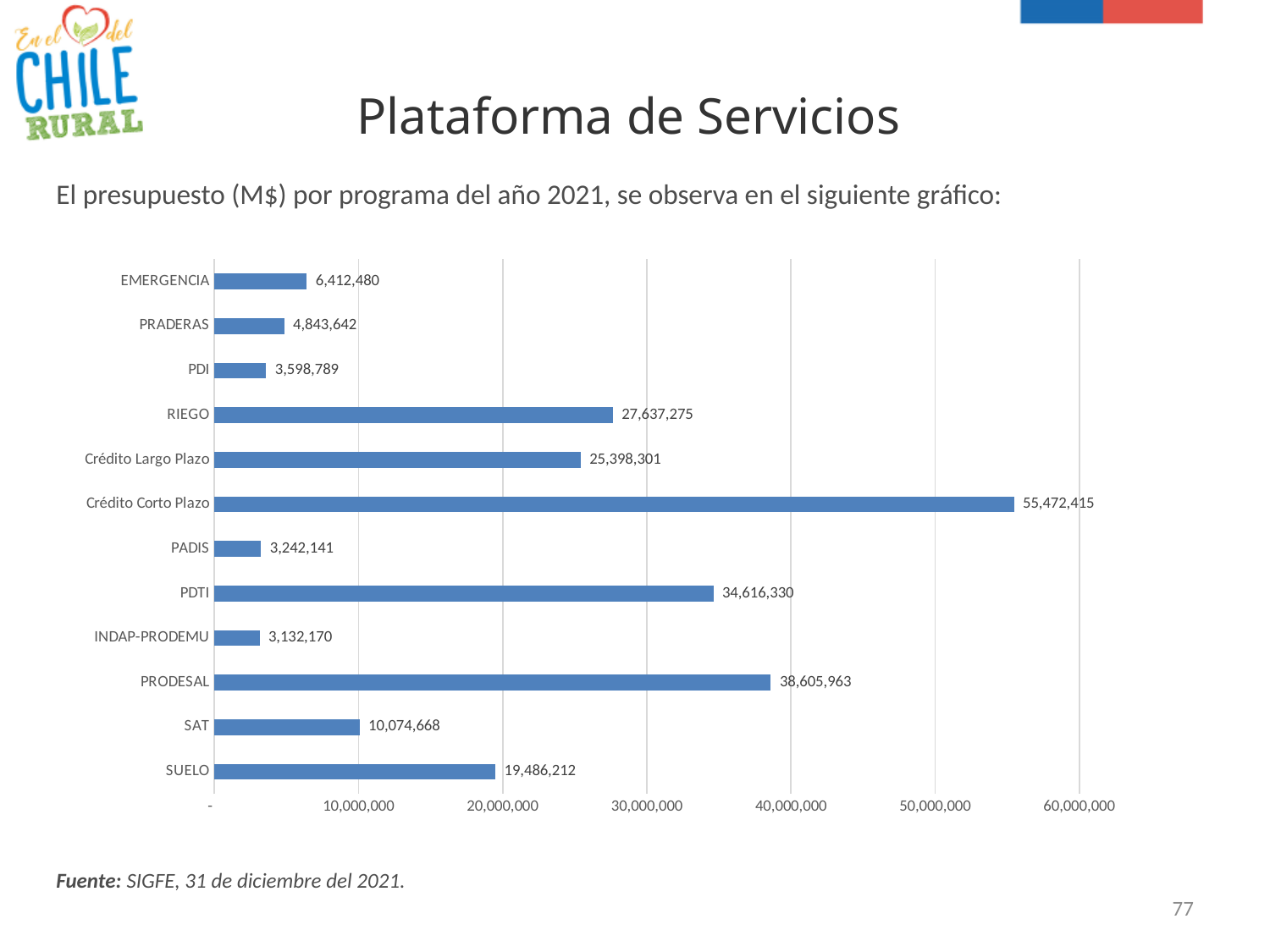
How many programs are shown in the chart? 12 Which has a larger value, PDTI or RIEGO? PDTI Which program has the lowest budget in the chart? INDAP-PRODEMU Is the value for SUELO greater or less than 20,000,000? less What is the source cited below the chart? SIGFE, 31 de diciembre del 2021 What kind of chart is shown on the slide? bar chart Which program has the highest budget in the chart? Crédito Corto Plazo What is the value shown for SAT? 10,074,668 What is the budget value shown for PRODESAL? 38,605,963 What is the value shown for Crédito Largo Plazo? 25,398,301 What is the difference between the values for PRODESAL and PDTI? 3,989,633 What is the difference between the values for Crédito Corto Plazo and PRODESAL? 16,866,452